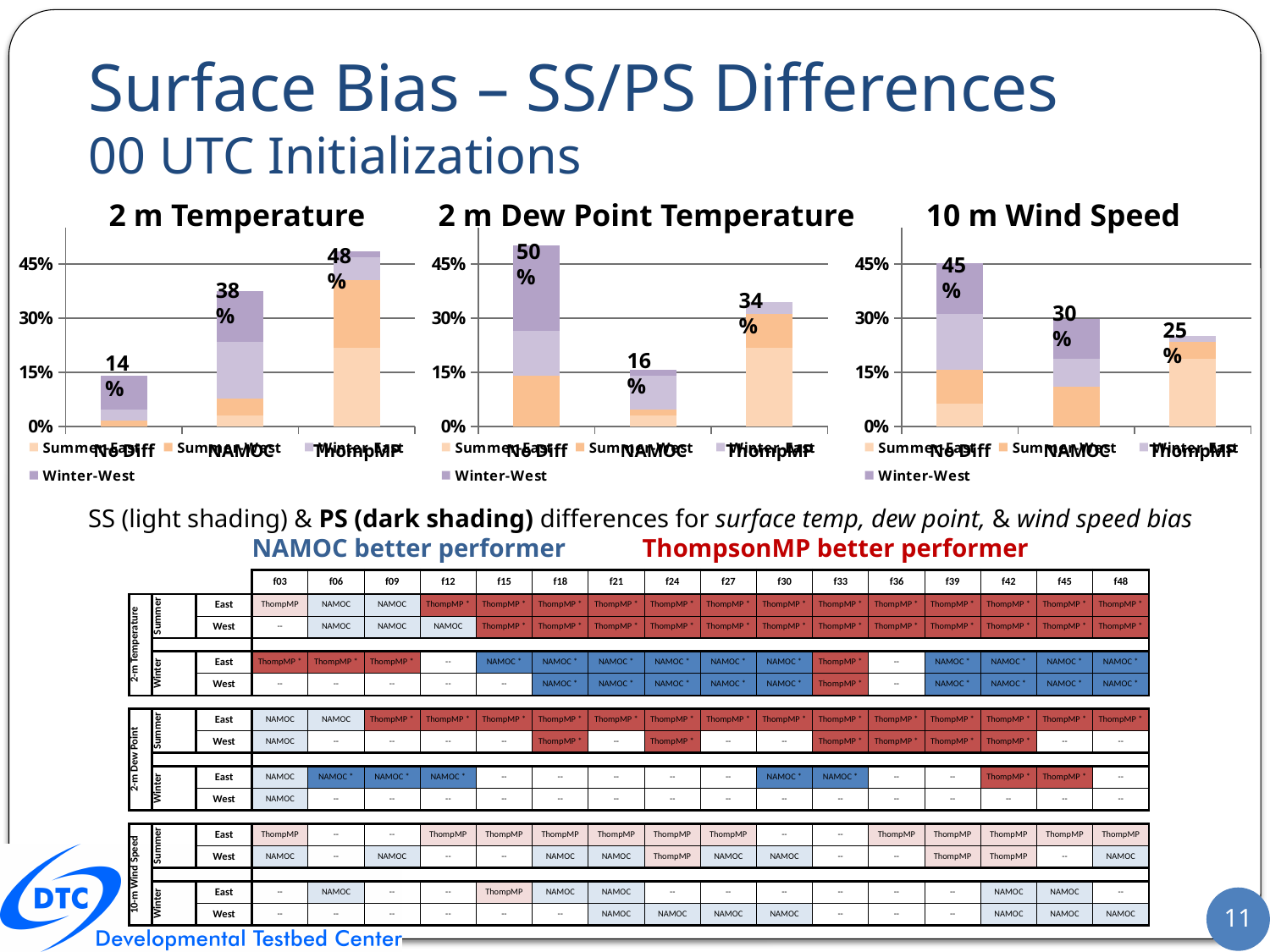
In the 2 m Dew Point Temperature chart, what is the total labeled for the No Diff bar? 50% How many series does the legend of the 2 m Temperature chart list? 4 In the 2 m Dew Point Temperature chart, which category has the highest total? No Diff What kind of chart is the 2 m Dew Point Temperature chart? Stacked bar chart In the 10 m Wind Speed chart, is the total for No Diff greater or less than 30%? greater How many categories are shown on the x axis of the 10 m Wind Speed chart? 3 In the 2 m Temperature chart, what is the total labeled for the ThompMP bar? 48% In the 10 m Wind Speed chart, which category has the lowest total? ThompMP In the 2 m Dew Point Temperature chart, which is larger, the NAMOC total or the ThompMP total? ThompMP In the 2 m Temperature chart, what is the difference between the ThompMP total and the No Diff total? 34% In the 10 m Wind Speed chart, what is the total labeled for the NAMOC bar? 30% In the 2 m Temperature chart, which category has the lowest total? No Diff